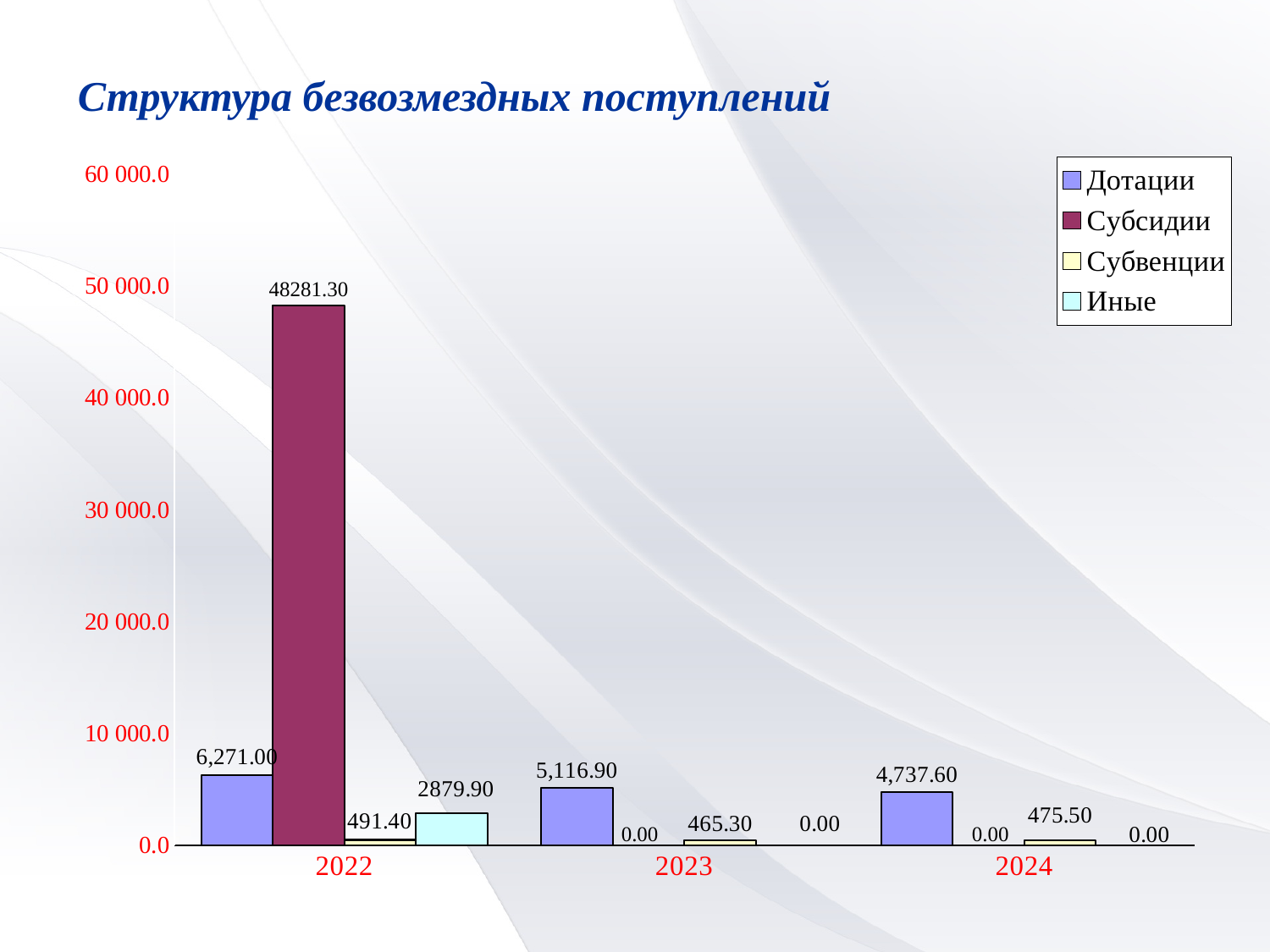
What is the value of Субсидии in 2022? 48281.30 How many series does the legend list? 4 Which year has the lowest value for Дотации? 2024 How do the values for Дотации change from 2022 to 2024? They fall What is the value of Иные in 2022? 2879.90 What is the title of the chart? Структура безвозмездных поступлений How many years are shown on the x axis? 3 What type of chart is shown on the slide? bar chart What is the value of Дотации in 2023? 5,116.90 What is the value of Субвенции in 2024? 475.50 Is the value of Дотации in 2022 larger or smaller than the value of Дотации in 2024? larger Which series has the highest value in 2022? Субсидии